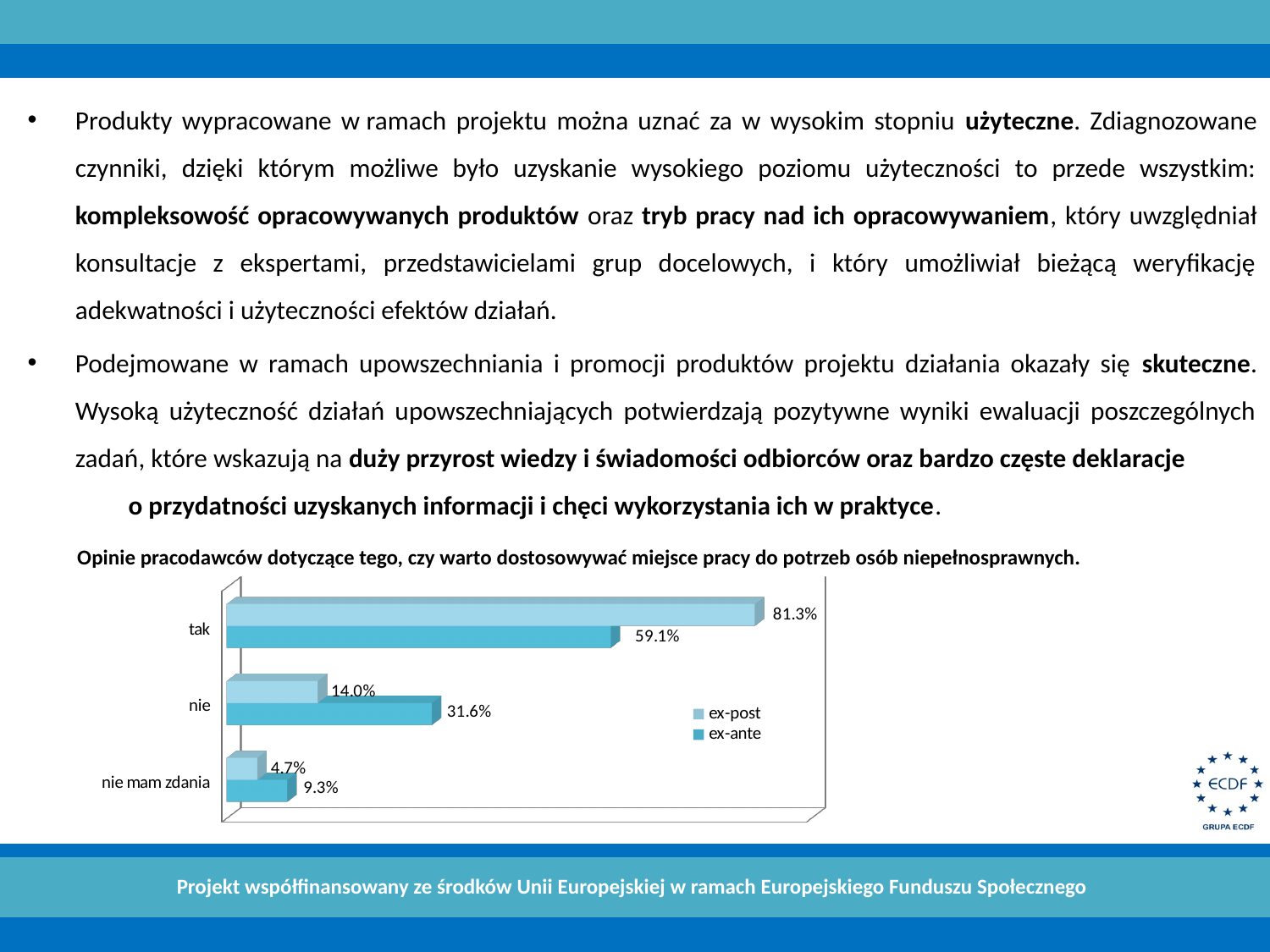
Which category has the lowest ex-ante value? nie mam zdania How many series does the legend list? 2 What is the ex-ante value for "nie mam zdania"? 9.3% What is the difference between the ex-ante and ex-post values for "nie"? 17.6% What is the ex-post value for "nie"? 14.0% What is the difference between the ex-post and ex-ante values for "tak"? 22.2% For "nie", which is larger: the ex-post or the ex-ante value? ex-ante What is the ex-ante value for "tak"? 59.1% What is the ex-post value for "tak"? 81.3% How many categories are shown on the chart? 3 What kind of chart is shown on the slide? bar chart Which category has the highest ex-post value? tak